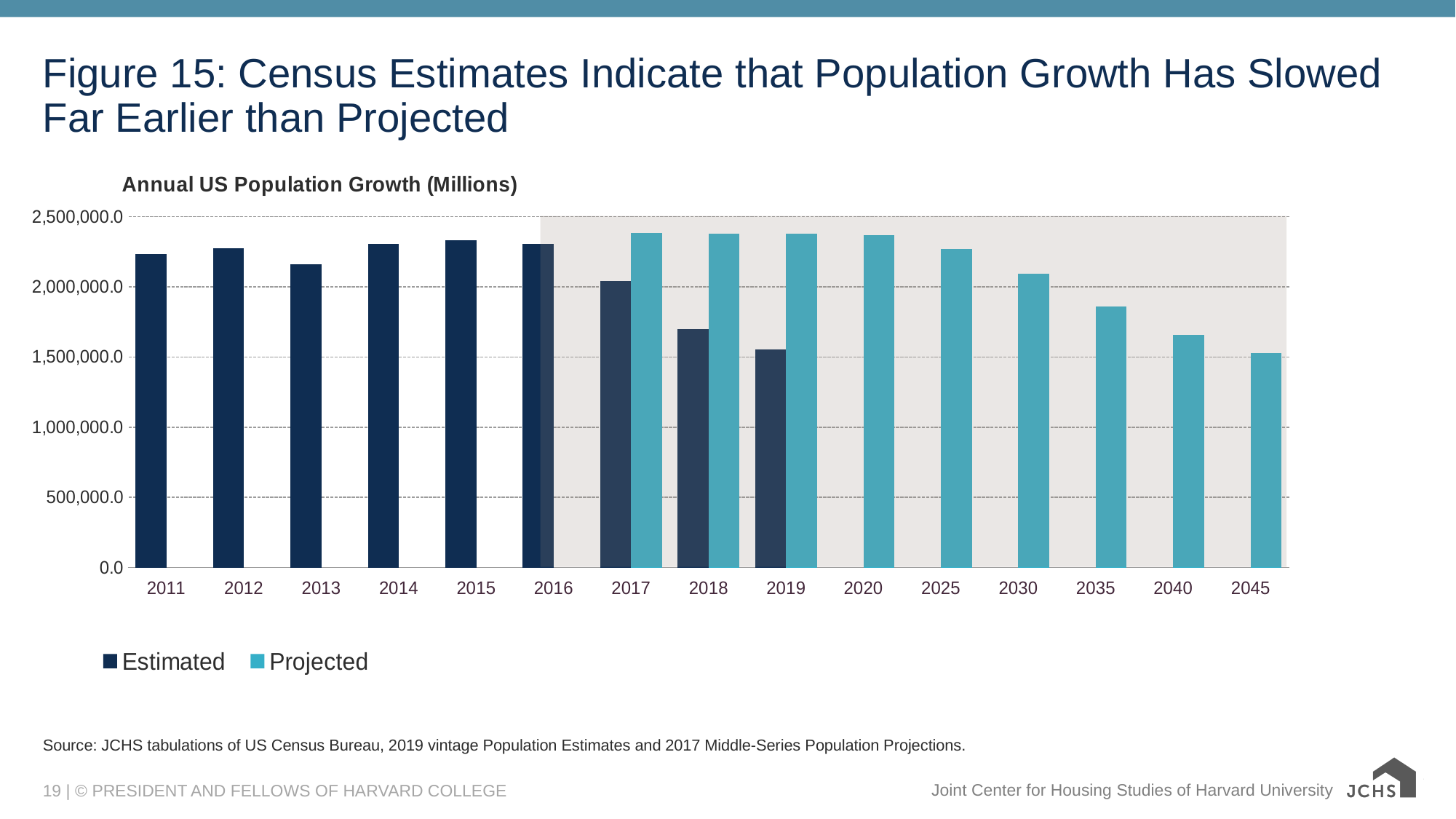
What kind of chart is shown on the slide? bar chart How many series does the legend list? 2 Is the Projected value for 2030 greater or less than 2,000,000.0? greater How many years are shown on the x axis? 15 Is the Projected value for 2035 greater or less than 2,000,000.0? less Is the Estimated value for 2018 greater or less than 2,000,000.0? less Which year has the lowest Estimated value? 2019 What is the title of the chart? Annual US Population Growth (Millions) Which year has the lowest Projected value? 2045 For 2018, which is larger, the Estimated value or the Projected value? Projected Do the Projected values rise or fall from 2017 to 2045? fall